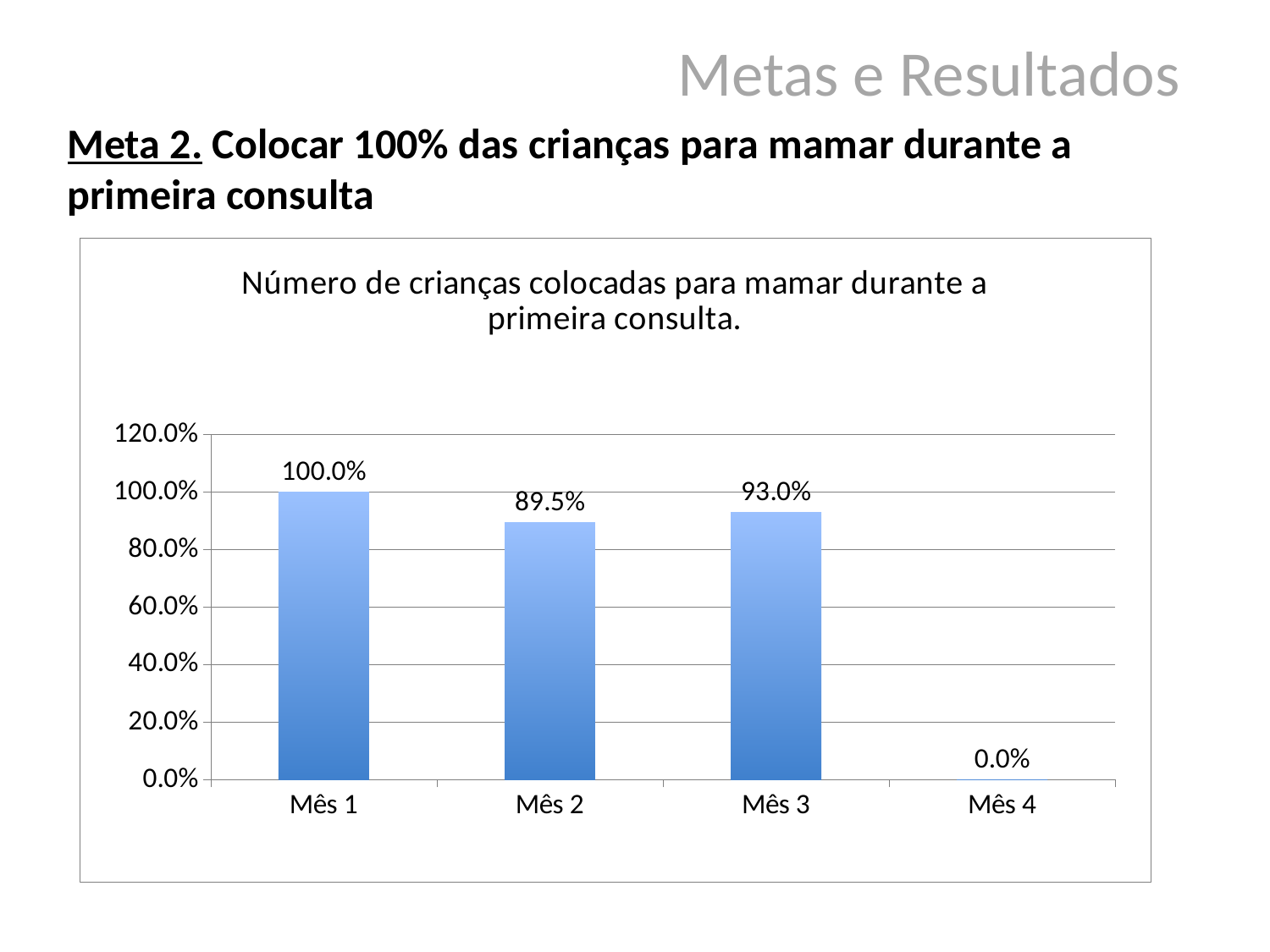
What is the value for Mês 2? 89.5% What is the value for Mês 1? 100.0% What is the title of the chart? Número de crianças colocadas para mamar durante a primeira consulta. What is the difference between the values for Mês 1 and Mês 2? 10.5% What is the value for Mês 4? 0.0% What is the value for Mês 3? 93.0% What is the difference between the values for Mês 3 and Mês 2? 3.5% How many categories are shown on the x axis? 4 Which month has the lowest value? Mês 4 Which month has the highest value? Mês 1 What kind of chart is shown? Bar chart Which is larger, the value for Mês 2 or Mês 3? Mês 3